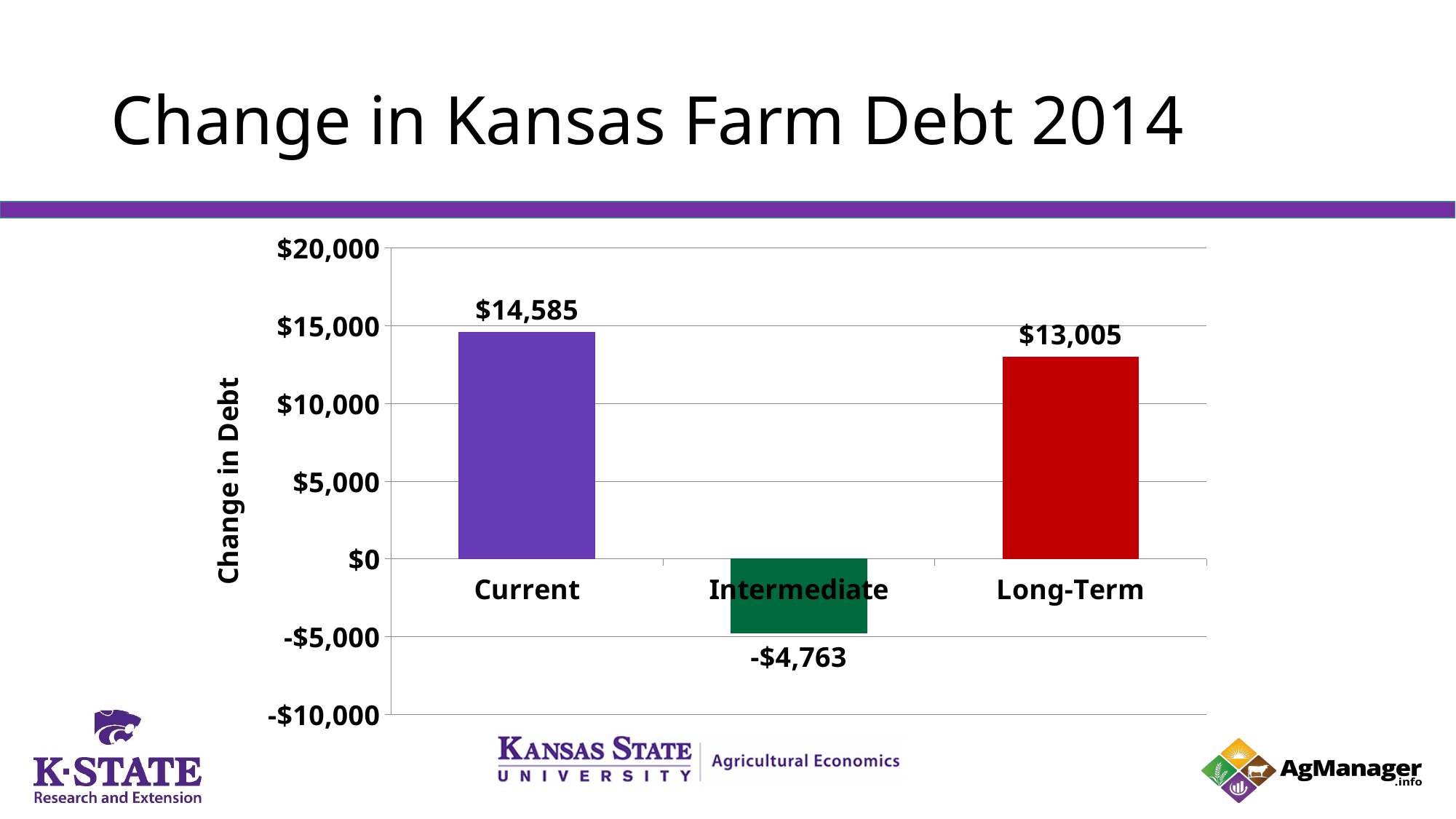
Which category has the lowest change in debt? Intermediate What kind of chart is shown on the slide? Bar chart Is the value for Long-Term greater or less than $10,000? greater What colour is the bar for Intermediate? Green Which category has the highest change in debt? Current Which is larger, the change in debt for Current or Long-Term? Current What is the change in debt for Intermediate? -$4,763 How many categories are shown in the chart? 3 What is the change in debt for Long-Term? $13,005 What is the difference between the change in debt for Current and Long-Term? $1,580 What is the label of the vertical axis? Change in Debt What is the change in debt for Current? $14,585